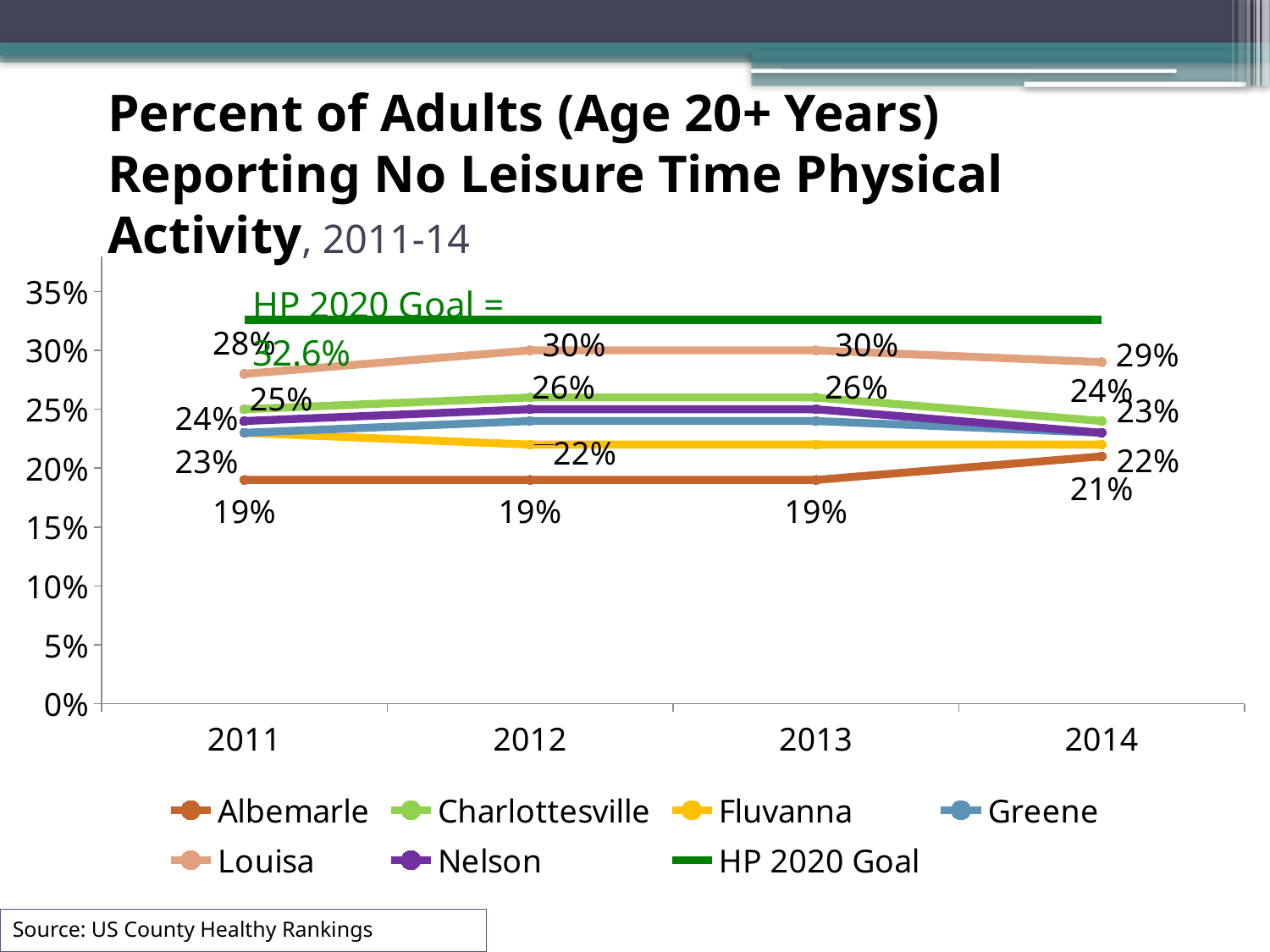
Is the value for Fluvanna in 2013 greater or less than 25%? less What is the value for Louisa in 2012? 30% What is the HP 2020 Goal value shown on the chart? 32.6% How many series does the legend list? 7 Which is larger in 2014, Louisa or Charlottesville? Louisa Which county has the lowest value in 2011? Albemarle How many years are shown on the x axis? 4 What is the value for Albemarle in 2014? 21% What is the difference between Louisa and Albemarle in 2012? 11 percentage points Which county has the highest value in 2013? Louisa What is the value for Charlottesville in 2013? 26% What kind of chart is this? line chart